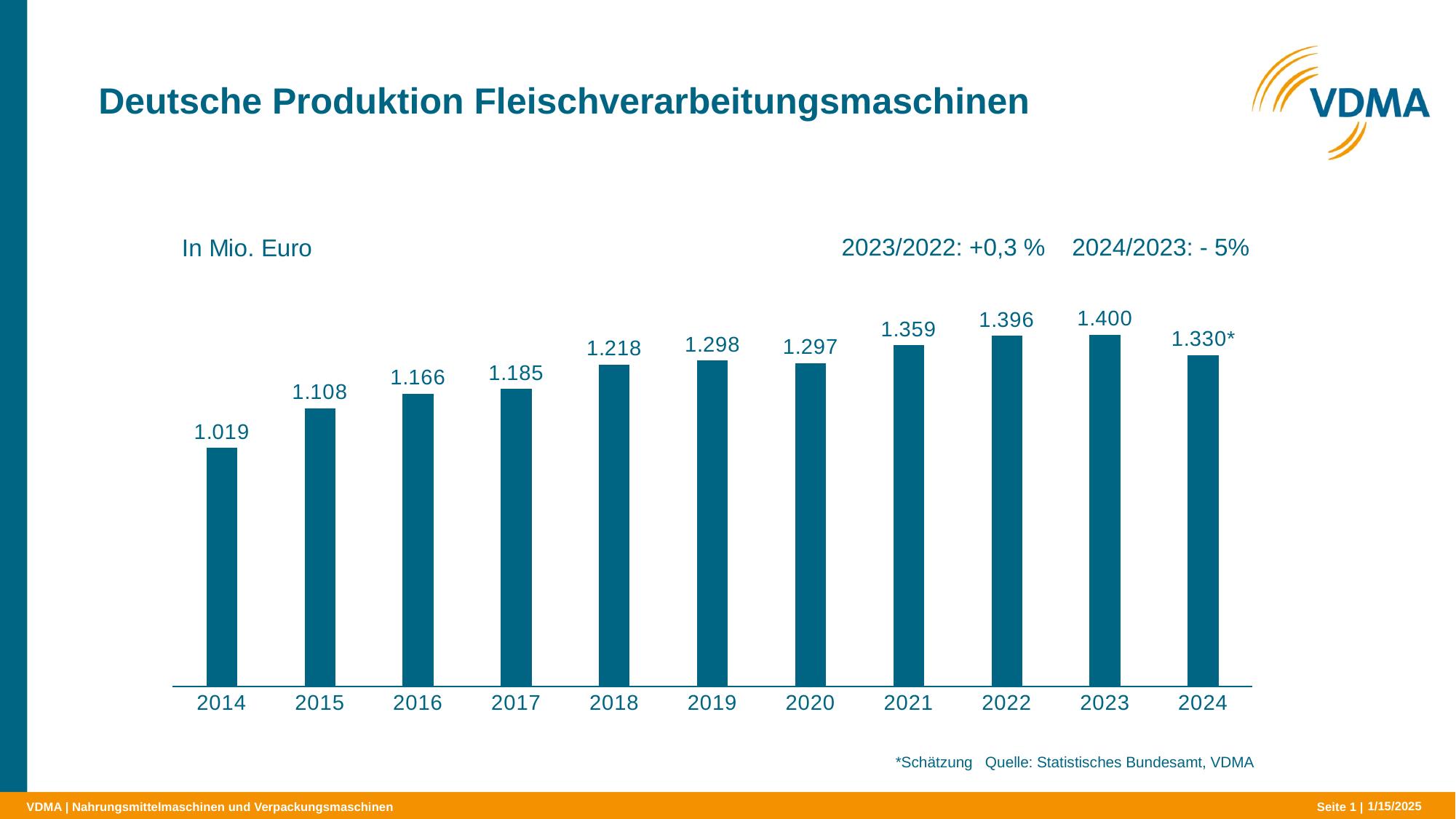
Do the values rise or fall from 2014 to 2018? rise What is the value for 2014? 1.019 In what unit are the values given, according to the label on the chart? In Mio. Euro Which year has the highest value? 2023 Which is larger, the value for 2018 or the value for 2021? 2021 How many years are shown on the x axis? 11 What is the difference between the values for 2023 and 2014? 381 Which year has the lowest value? 2014 What is the difference between the values for 2022 and 2021? 37 What is the value shown for 2024? 1.330* What kind of chart is this? bar chart What is the value for 2019? 1.298